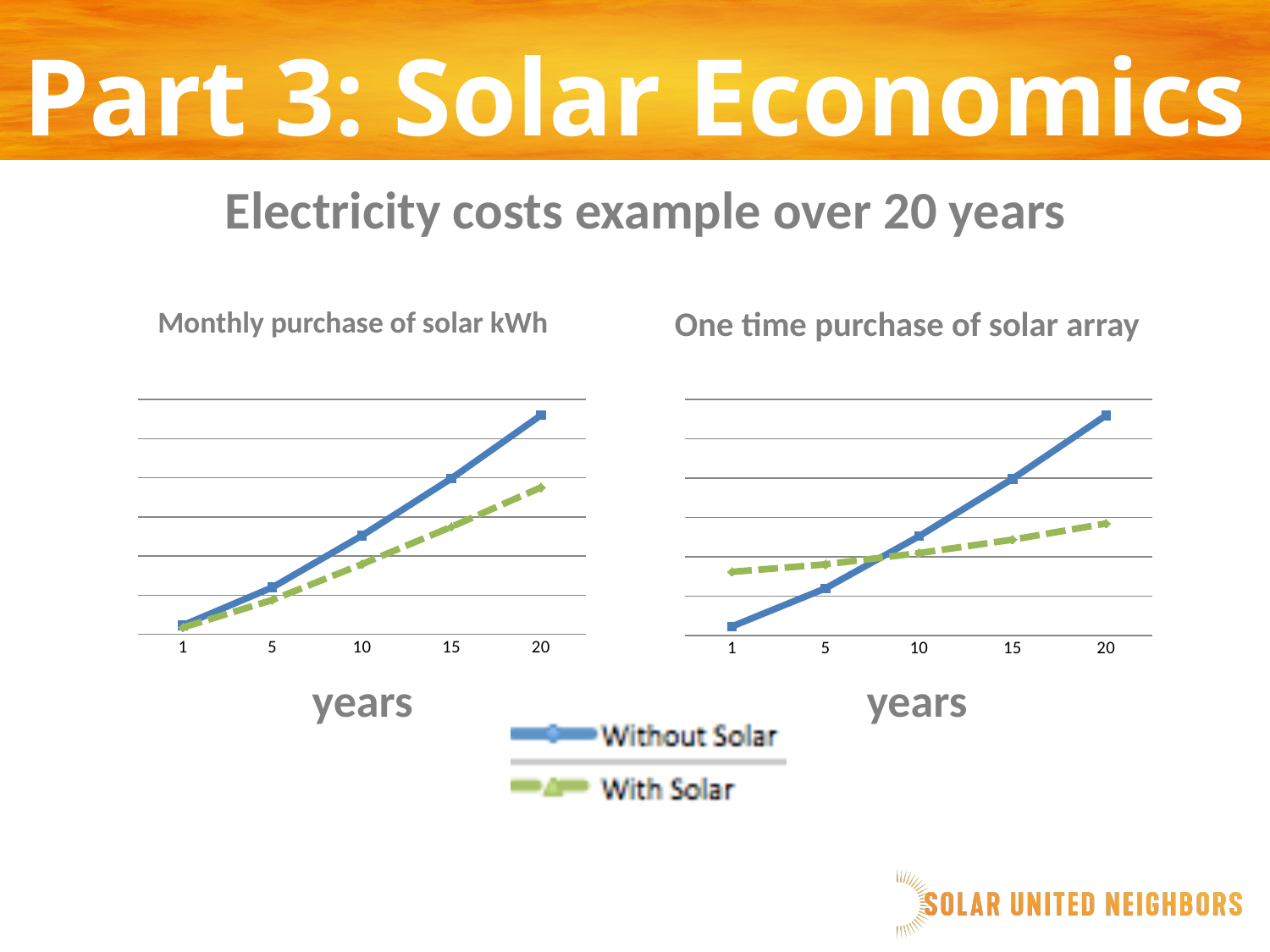
In the "Monthly purchase of solar kWh" chart, at which year does the Without Solar series reach its highest value? 20 In the "One time purchase of solar array" chart, which series is higher at year 1, Without Solar or With Solar? With Solar In the "One time purchase of solar array" chart, does the With Solar line rise or fall as the years increase? rise In the "Monthly purchase of solar kWh" chart, which series is higher at year 15, Without Solar or With Solar? Without Solar What kind of chart is the "Monthly purchase of solar kWh" chart? line chart How many points are plotted along the x axis in the "One time purchase of solar array" chart? 5 What kind of chart is the "One time purchase of solar array" chart? line chart How many points are plotted along the x axis in the "Monthly purchase of solar kWh" chart? 5 How many series does the legend list? 2 In the "Monthly purchase of solar kWh" chart, does the Without Solar line rise or fall as the years increase? rise What label is shown on the x axis of both charts? years In the "One time purchase of solar array" chart, which series is higher at year 20, Without Solar or With Solar? Without Solar